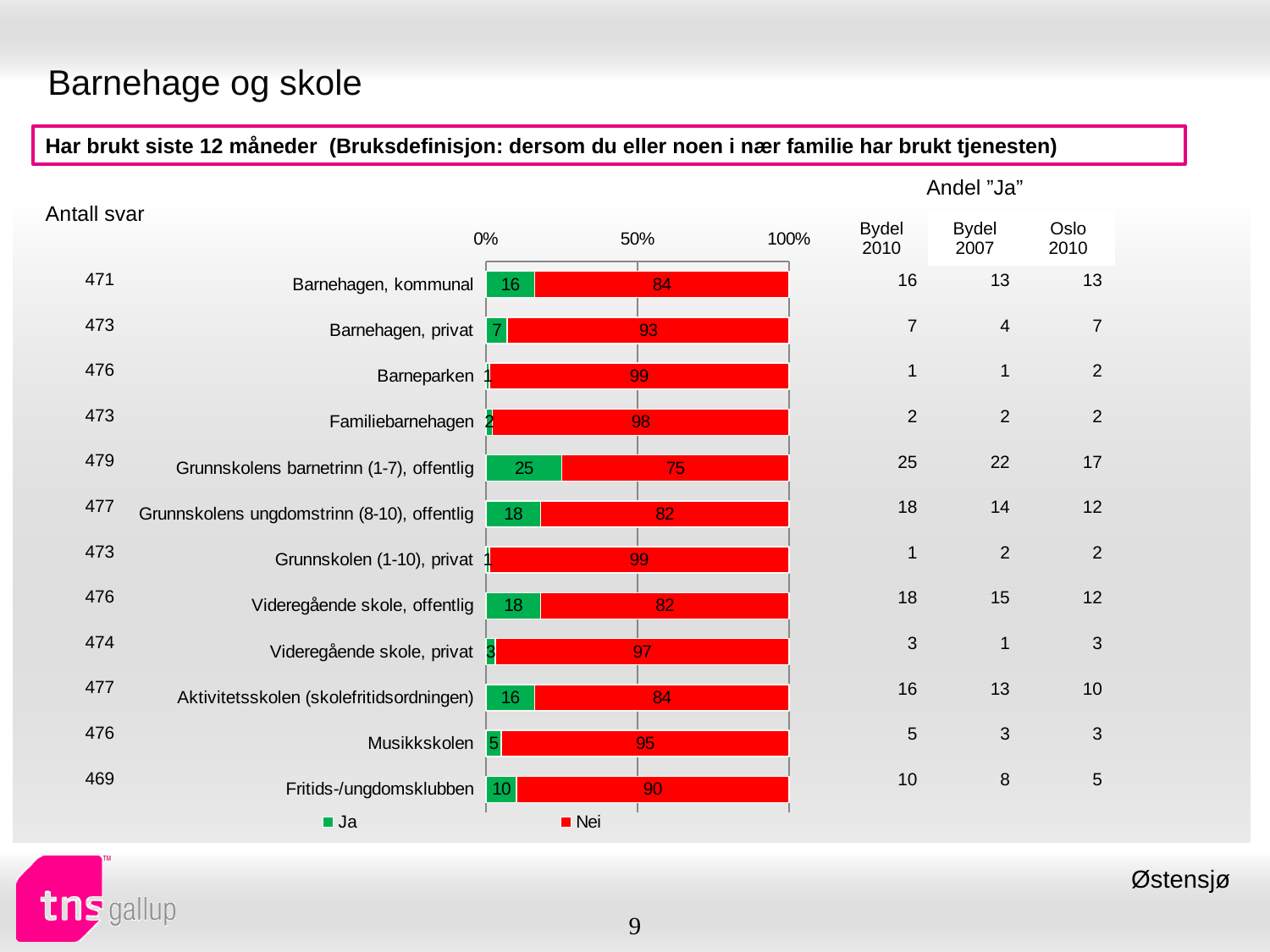
What is the "Ja" value for Barnehagen, kommunal? 16 Is the "Nei" value for Fritids-/ungdomsklubben greater or less than 50%? greater Which has a larger "Ja" value: Barnehagen, kommunal or Barnehagen, privat? Barnehagen, kommunal What is the "Nei" value for Musikkskolen? 95 Which category has the lowest "Nei" value? Grunnskolens barnetrinn (1-7), offentlig What is the difference between the "Nei" and "Ja" values for Musikkskolen? 90 How many categories are shown in the chart? 12 What is the total of the stacked bar for Aktivitetsskolen (skolefritidsordningen)? 100 What kind of chart is shown on the slide? stacked bar chart Which category has the highest "Ja" value? Grunnskolens barnetrinn (1-7), offentlig What is the "Ja" value for Fritids-/ungdomsklubben? 10 How many series does the legend list? 2